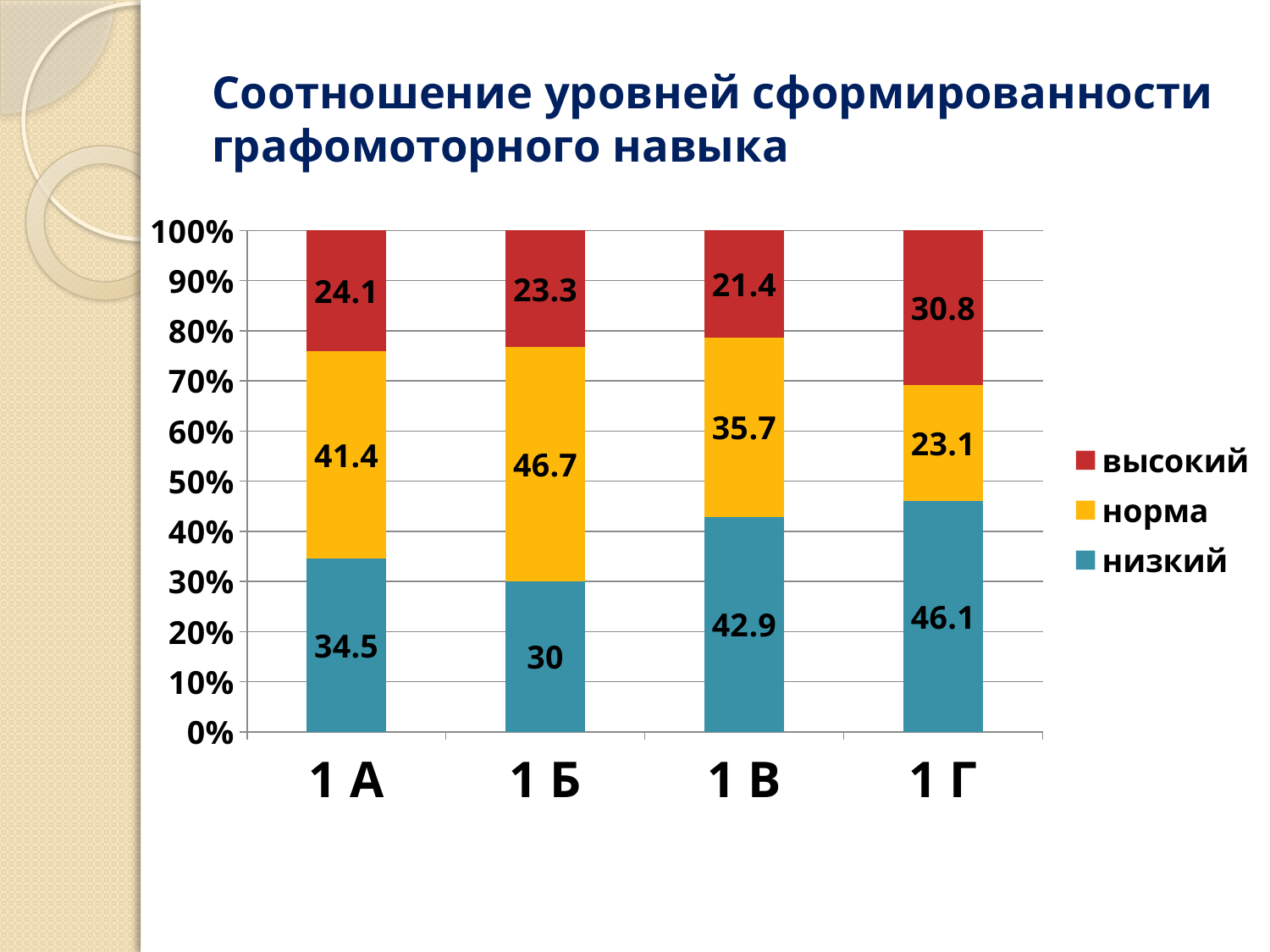
What is the value of the низкий series for 1 А? 34.5 What is the value of the норма series for 1 Б? 46.7 What kind of chart is shown on the slide? Stacked bar chart What is the difference between the низкий values for 1 Г and 1 Б? 16.1 Which category has the highest value for the низкий series? 1 Г How many series does the legend list? 3 How many categories are shown on the x axis? 4 Which category has the lowest value for the норма series? 1 Г What is the value of the высокий series for 1 Г? 30.8 What is the value of the норма series for 1 В? 35.7 Which category has the lowest value for the высокий series? 1 В Which is larger: the норма value for 1 А or the норма value for 1 В? 1 А